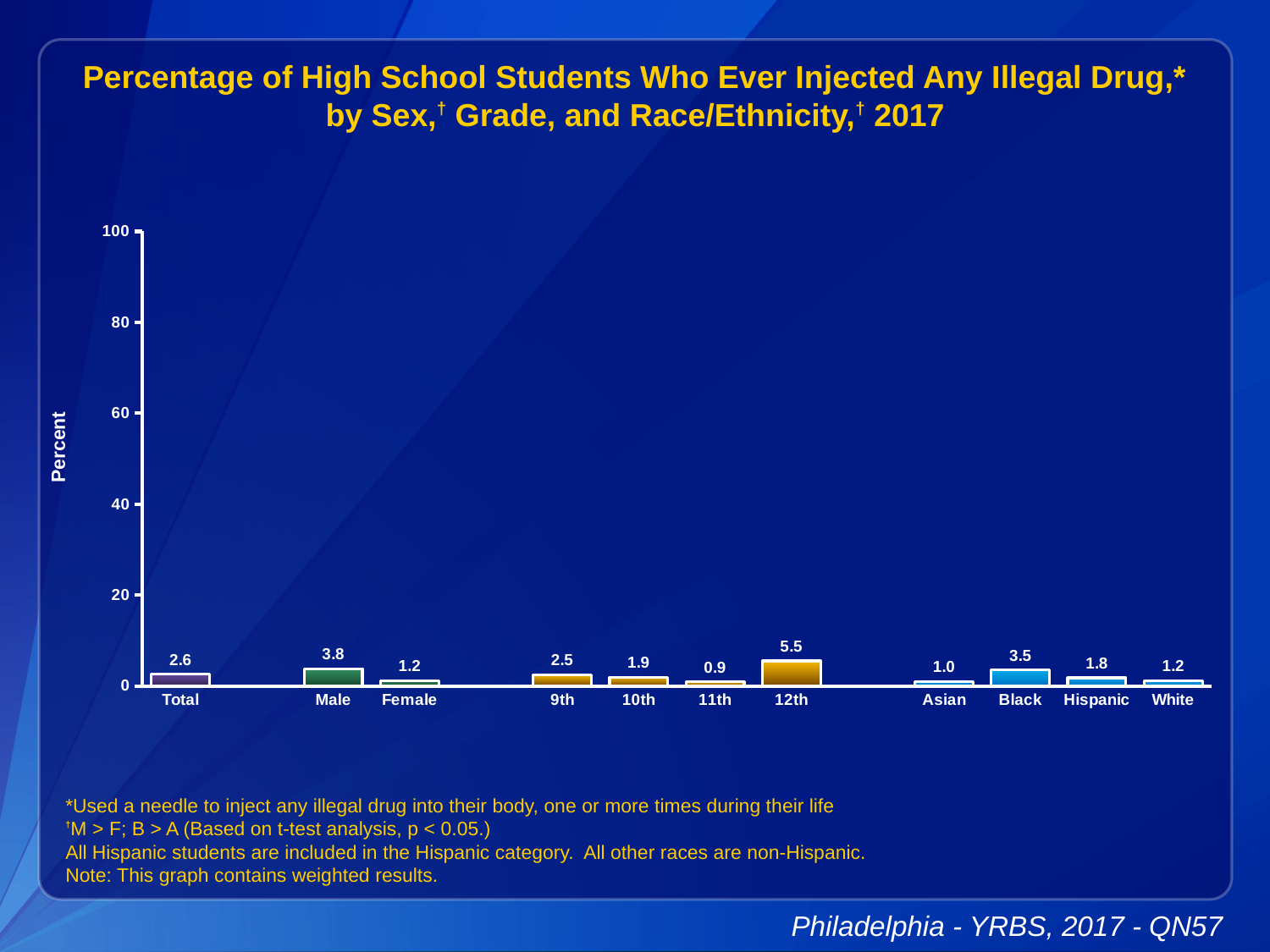
Which category has the highest value? 12th What is the value for 12th grade? 5.5 What is the value for Total? 2.6 Which category has the lowest value? 11th What is the difference between the Male and Female values? 2.6 What kind of chart is this? bar chart Which is larger, the value for Black or the value for Asian? Black What is the value for Male? 3.8 What is the value for Hispanic? 1.8 What is the label on the y axis? Percent Is the value for 12th grade greater or less than 20? less How many categories are shown on the x axis? 11